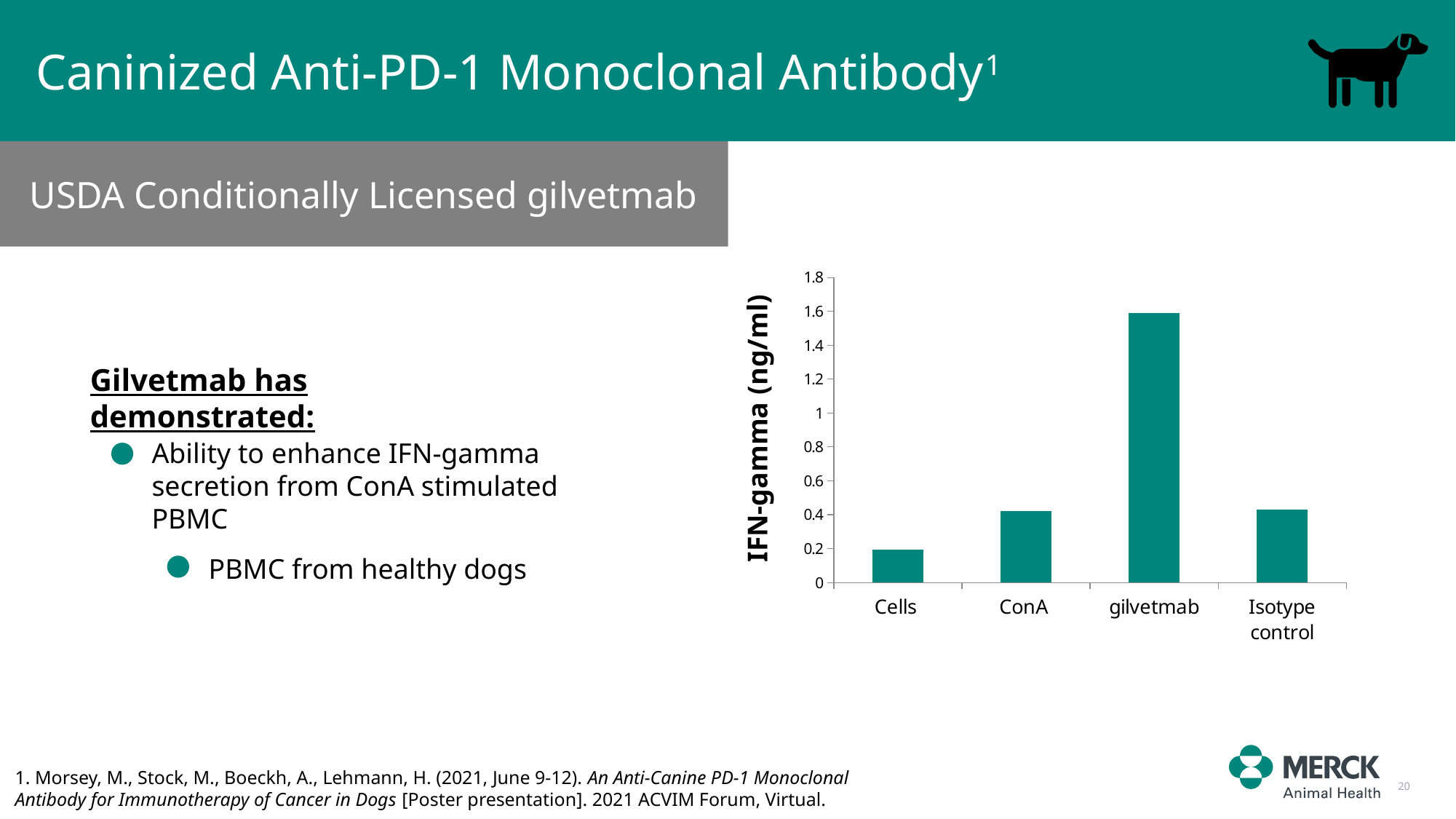
Is the value for Isotype control greater or less than 0.2? greater Which category has the lowest IFN-gamma value in the chart? Cells Which is larger, the value for Cells or the value for Isotype control? Isotype control What is the label on the y axis of the chart? IFN-gamma (ng/ml) Is the value for gilvetmab greater or less than 1.4? greater Is the value for ConA greater or less than 0.6? less Which category has the highest IFN-gamma value in the chart? gilvetmab How many categories are plotted on the x axis of the chart? 4 What is the highest tick value shown on the y axis of the chart? 1.8 What kind of chart is shown on the slide? bar chart Which is larger, the value for gilvetmab or the value for ConA? gilvetmab